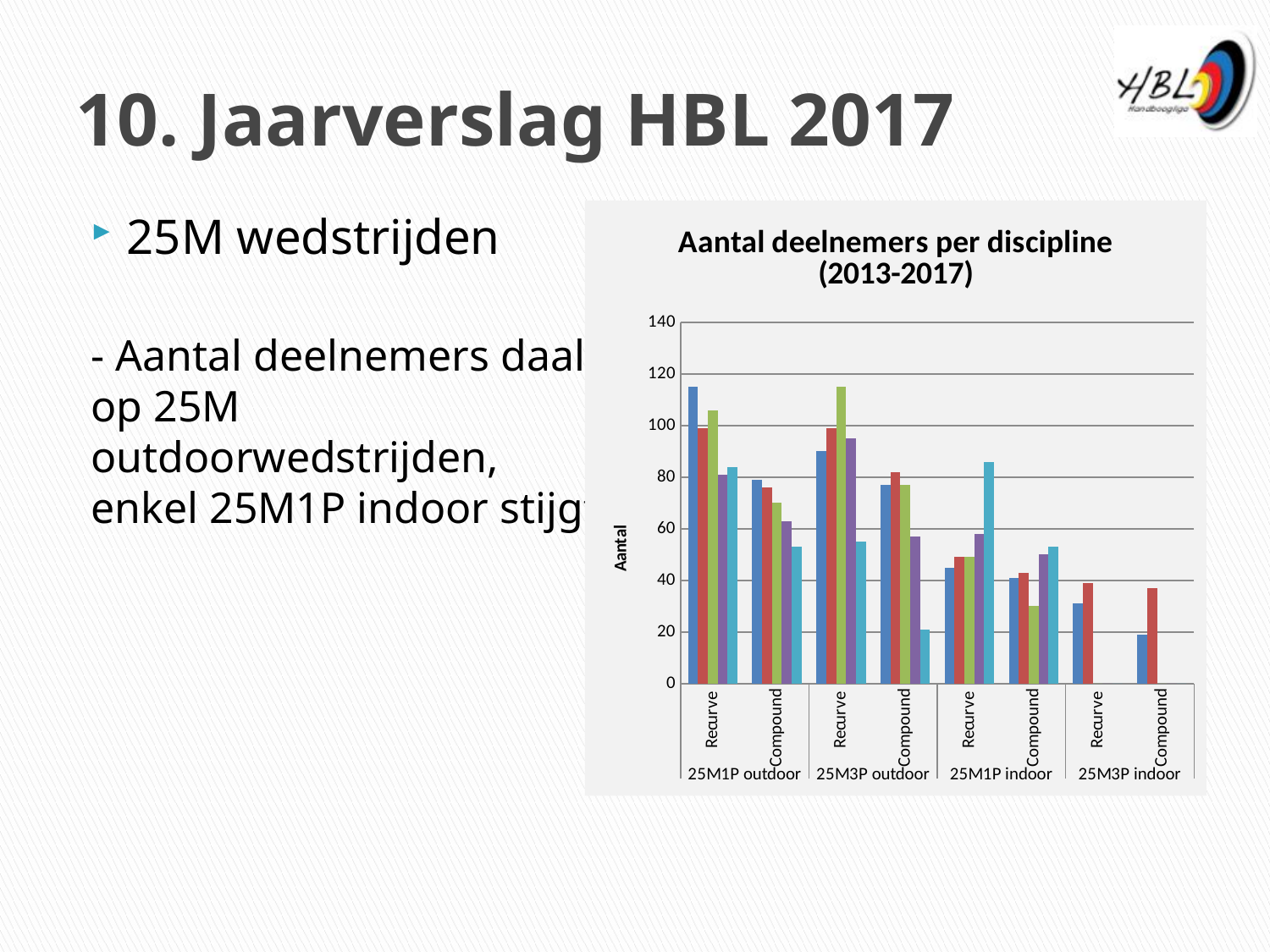
Is the tallest bar for Compound in the 25M3P indoor group greater or less than 60? less What kind of chart is shown on the slide? Bar chart What is the highest value shown on the vertical axis of the chart? 140 How many bars are plotted for Recurve in the 25M3P indoor group? 2 Is the tallest bar for Recurve in the 25M1P outdoor group greater or less than 100? greater How many discipline groups are labelled along the x axis of the chart? 4 What is the label on the vertical axis of the chart? Aantal Is the tallest bar for Compound in the 25M1P indoor group greater or less than 80? less What is the title of the chart? Aantal deelnemers per discipline (2013-2017) How many bars are plotted for Compound in the 25M1P indoor group? 5 Which is taller: the tallest bar for Recurve in 25M1P outdoor or the tallest bar for Recurve in 25M3P indoor? Recurve in 25M1P outdoor